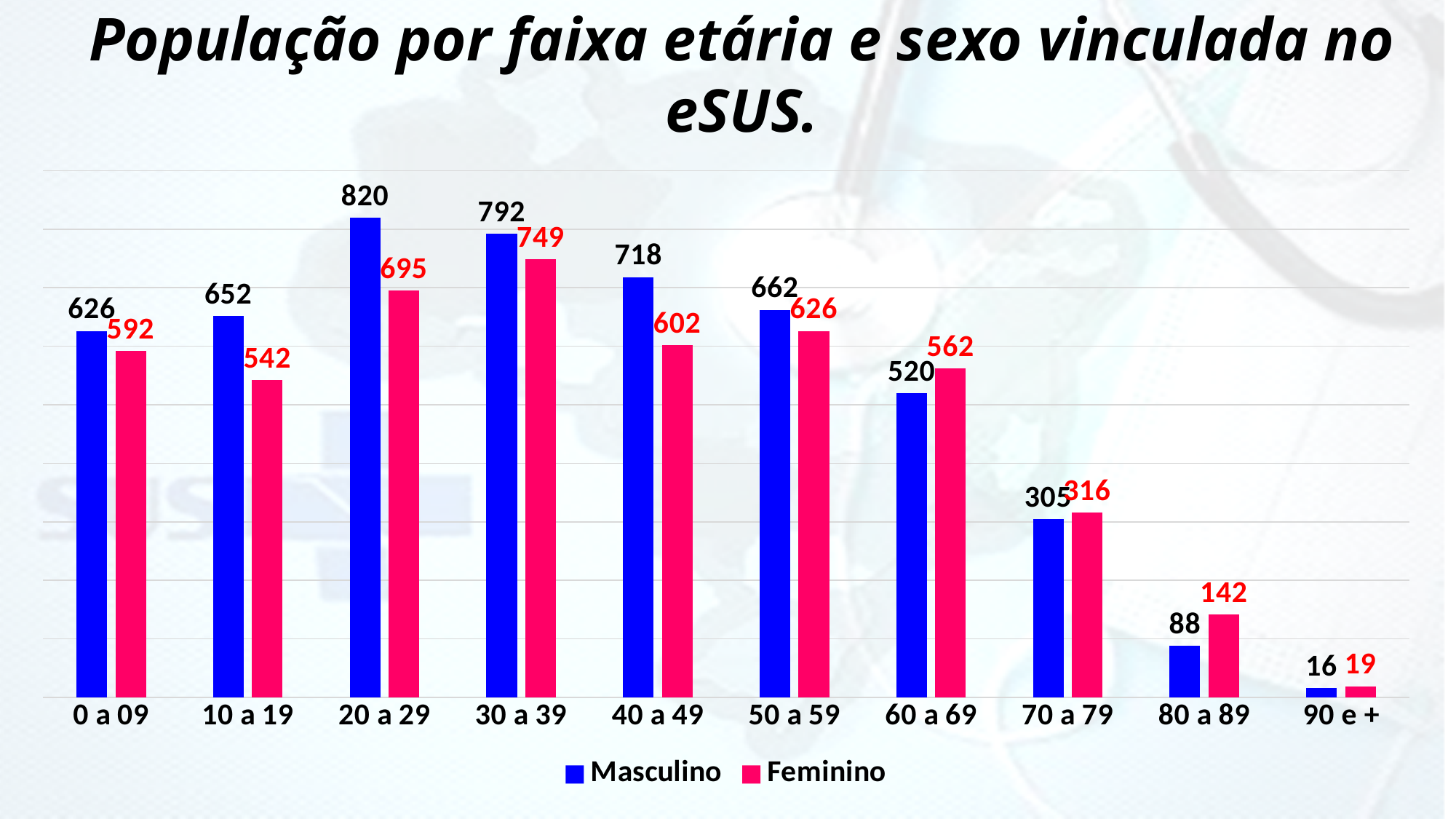
What is the Masculino value for the 20 a 29 age group? 820 Which age group has the highest Masculino value? 20 a 29 How many age groups are shown on the x axis? 10 What is the difference between the Masculino and Feminino values for the 10 a 19 age group? 110 What is the Feminino value for the 80 a 89 age group? 142 What colour are the Feminino bars? Pink Which age group has the lowest Feminino value? 90 e + Do the Masculino values rise or fall from the 30 a 39 age group to the 90 e + age group? Fall What kind of chart is shown on the slide? Bar chart How many series does the legend list? 2 Which is larger for the 60 a 69 age group, Masculino or Feminino? Feminino What is the Feminino value for the 40 a 49 age group? 602